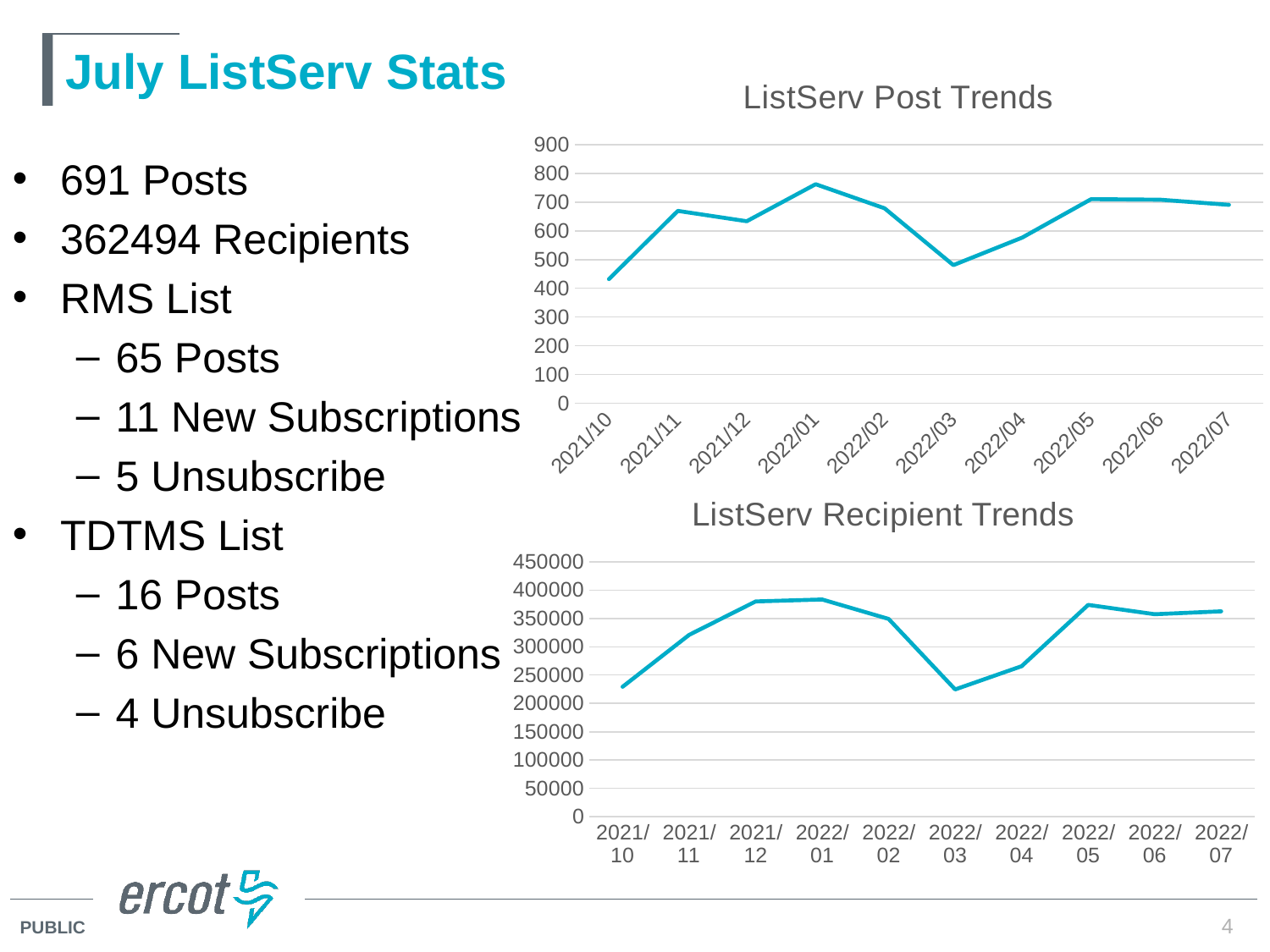
On the ListServ Recipient Trends chart, is the value for 2022/03 greater or less than 250000? less How many months are plotted on the ListServ Post Trends chart? 10 On the ListServ Post Trends chart, which month has the highest number of posts? 2022/01 On the ListServ Post Trends chart, is the value for 2021/10 greater or less than 500? less On the ListServ Post Trends chart, do the values rise or fall from 2022/03 to 2022/05? rise On the ListServ Post Trends chart, which month has the lowest number of posts? 2021/10 On the ListServ Post Trends chart, is the value for 2022/01 greater or less than 700? greater On the ListServ Recipient Trends chart, do the values rise or fall from 2022/01 to 2022/03? fall On the ListServ Post Trends chart, which is larger, the value for 2022/02 or the value for 2022/03? 2022/02 On the ListServ Recipient Trends chart, which is larger, the value for 2022/04 or the value for 2022/05? 2022/05 What kind of chart is the ListServ Post Trends chart? line chart